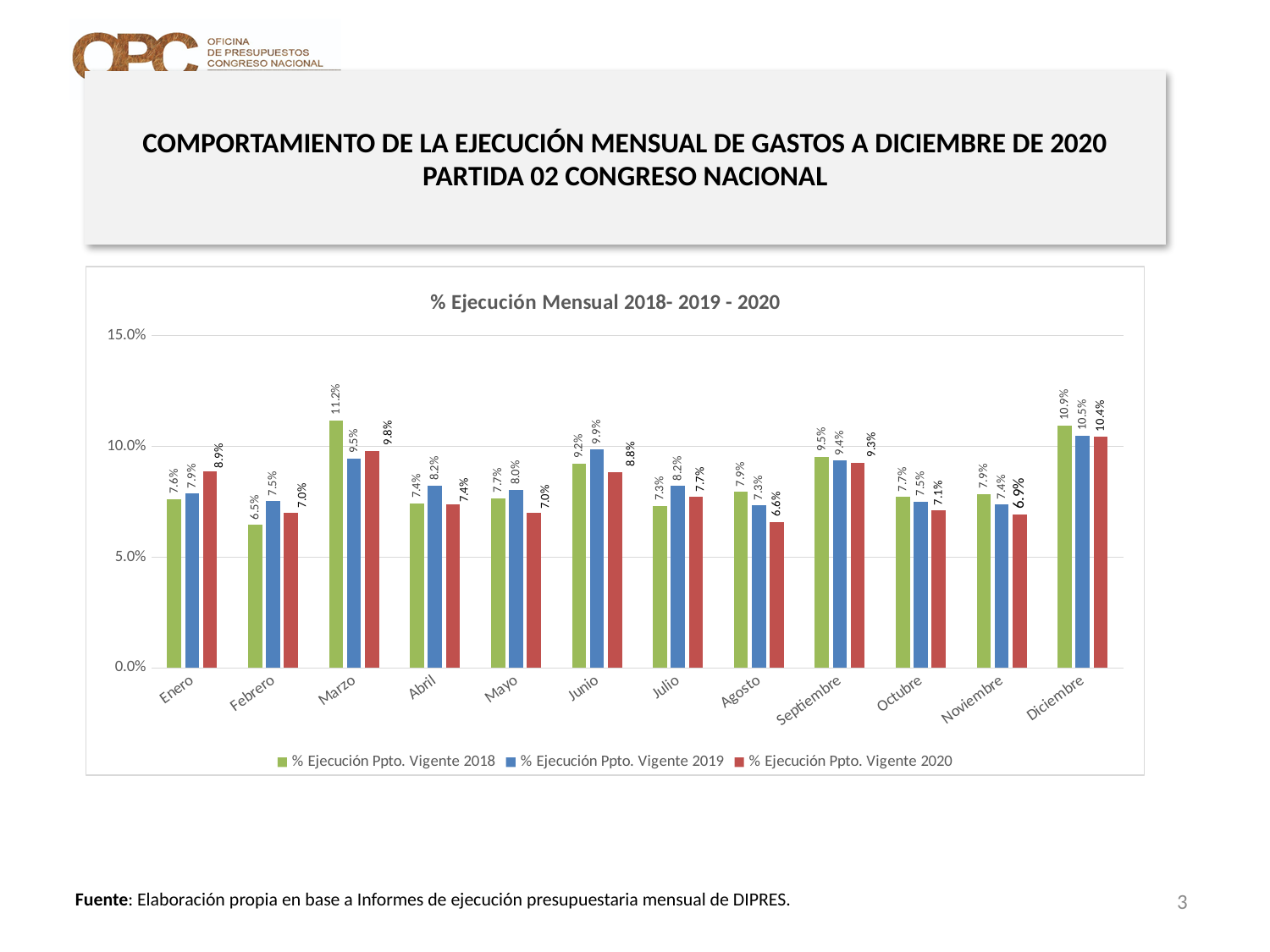
Which month has the highest value for % Ejecución Ppto. Vigente 2018? Marzo How many months are shown on the x axis? 12 How many series does the legend list? 3 Which is larger for Febrero: the 2019 value or the 2020 value? 2019 (7.5%) What kind of chart is shown on the slide? Bar chart Is the value of % Ejecución Ppto. Vigente 2018 for Diciembre greater or less than 10.0%? greater What is the value of % Ejecución Ppto. Vigente 2019 for Junio? 9.9% What is the difference between the 2018 and 2019 values for Marzo? 1.7% What is the value of % Ejecución Ppto. Vigente 2020 for Enero? 8.9% What is the value of % Ejecución Ppto. Vigente 2018 for Marzo? 11.2% Which month has the lowest value for % Ejecución Ppto. Vigente 2020? Agosto What is the title of the chart? % Ejecución Mensual 2018- 2019 - 2020